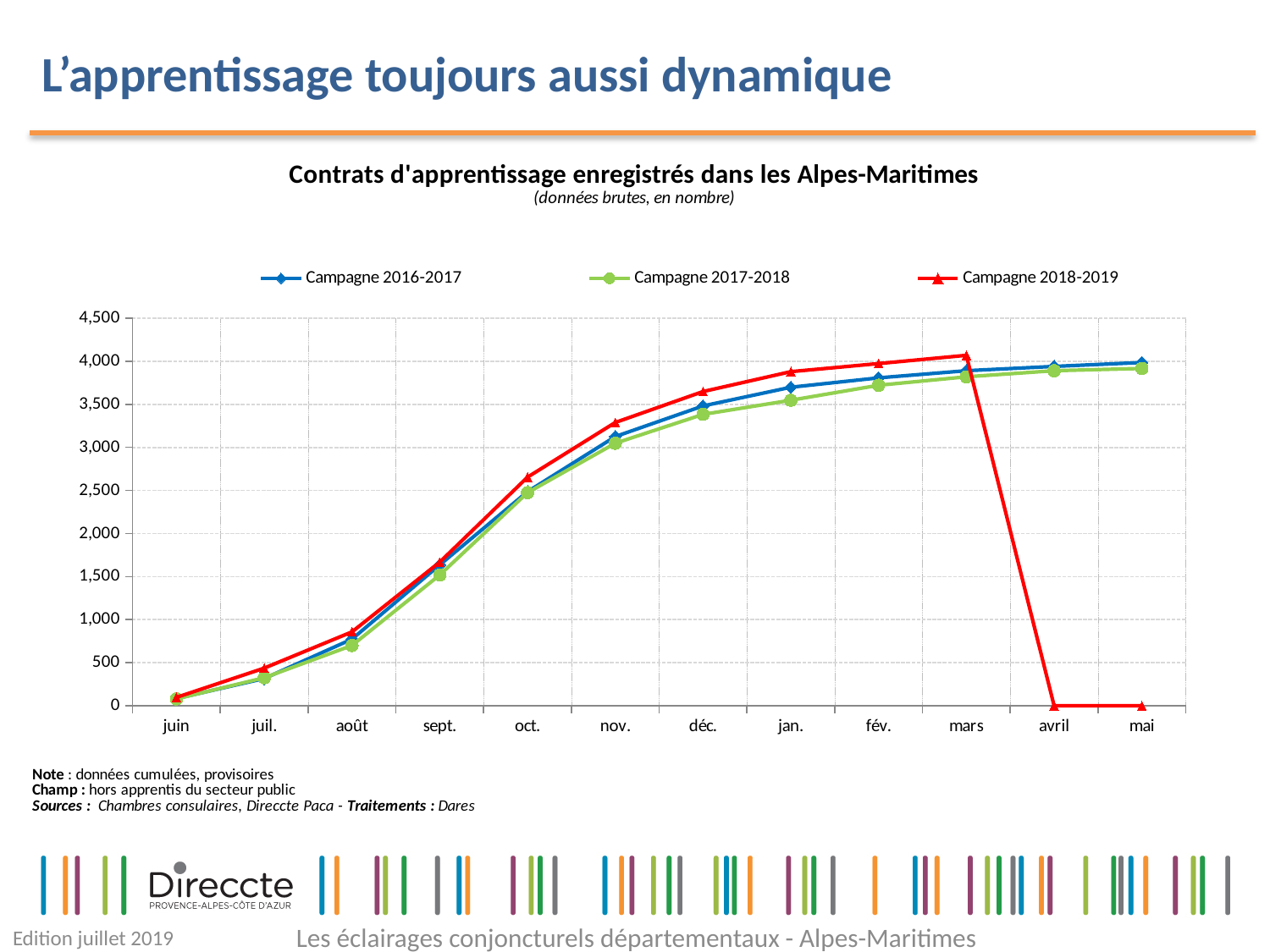
In which month is the value for Campagne 2017-2018 lowest? juin How many series does the legend list? 3 In mars, which series has the higher value: Campagne 2018-2019 or Campagne 2017-2018? Campagne 2018-2019 Is the value for Campagne 2018-2019 in oct. greater or less than 2,500? greater How many months are shown along the x axis? 12 Which series is drawn in red with triangle markers? Campagne 2018-2019 Do the values for Campagne 2016-2017 rise or fall from juin to mai? rise Is the value for Campagne 2016-2017 in jan. greater or less than 3,500? greater What kind of chart is shown on the slide? line chart What is the title of the chart? Contrats d'apprentissage enregistrés dans les Alpes-Maritimes Is the value for Campagne 2017-2018 in sept. greater or less than 2,000? less